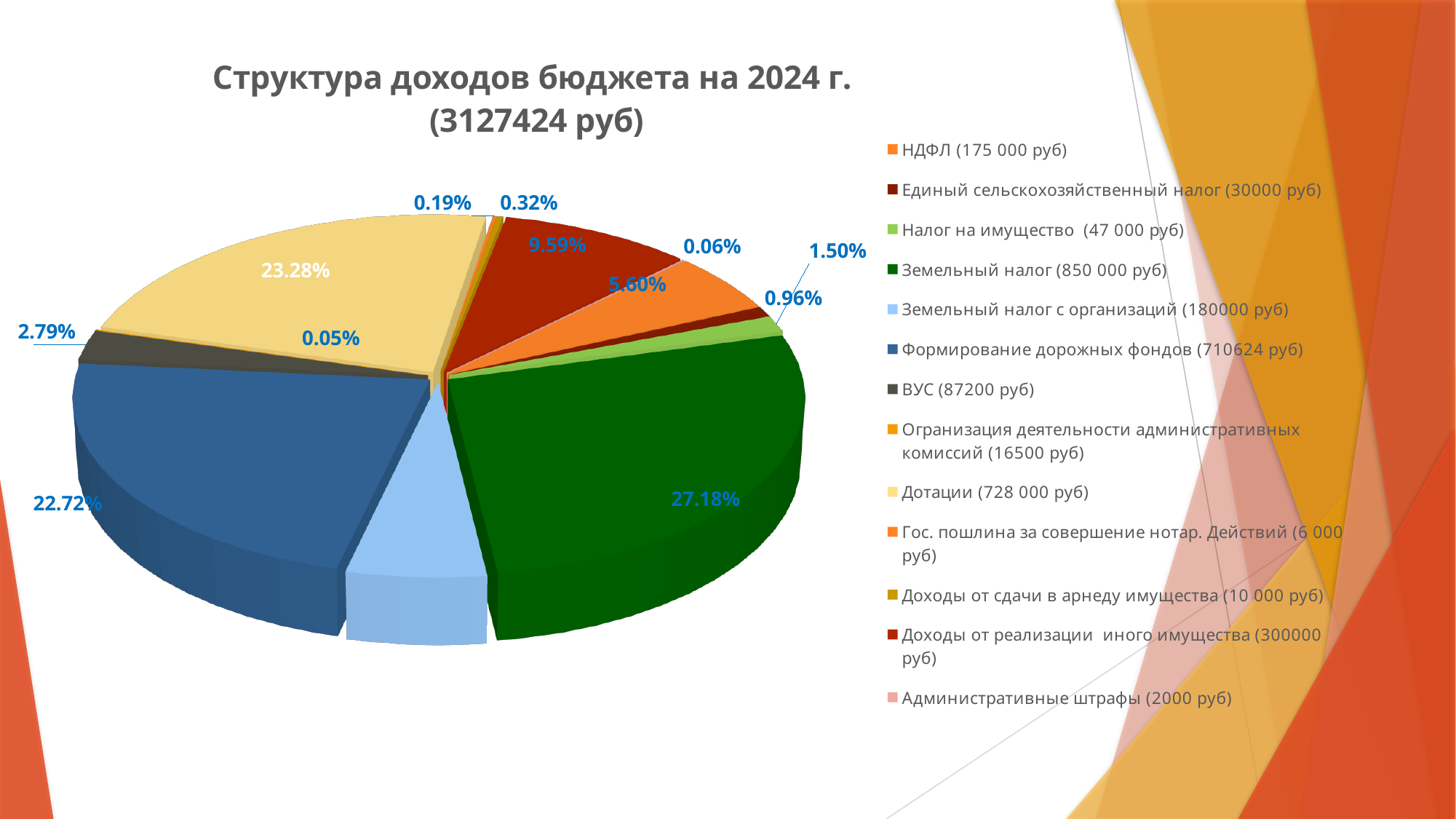
What share of the pie does Формирование дорожных фондов (710624 руб) have? 22.72% Which category has the largest slice of the pie? Земельный налог (850 000 руб) What share of the pie does НДФЛ (175 000 руб) have? 5.60% What is the title of the chart? Структура доходов бюджета на 2024 г. (3127424 руб) What kind of chart is shown on the slide? pie chart What is the difference in percentage points between the Земельный налог slice (27.18%) and the Дотации slice (23.28%)? 3.90% What share of the pie does Земельный налог (850 000 руб) have? 27.18% Which is larger: the share for Дотации or the share for Формирование дорожных фондов? Дотации How many entries does the legend list? 13 According to the legend, what amount in rubles is given for ВУС? 87200 руб